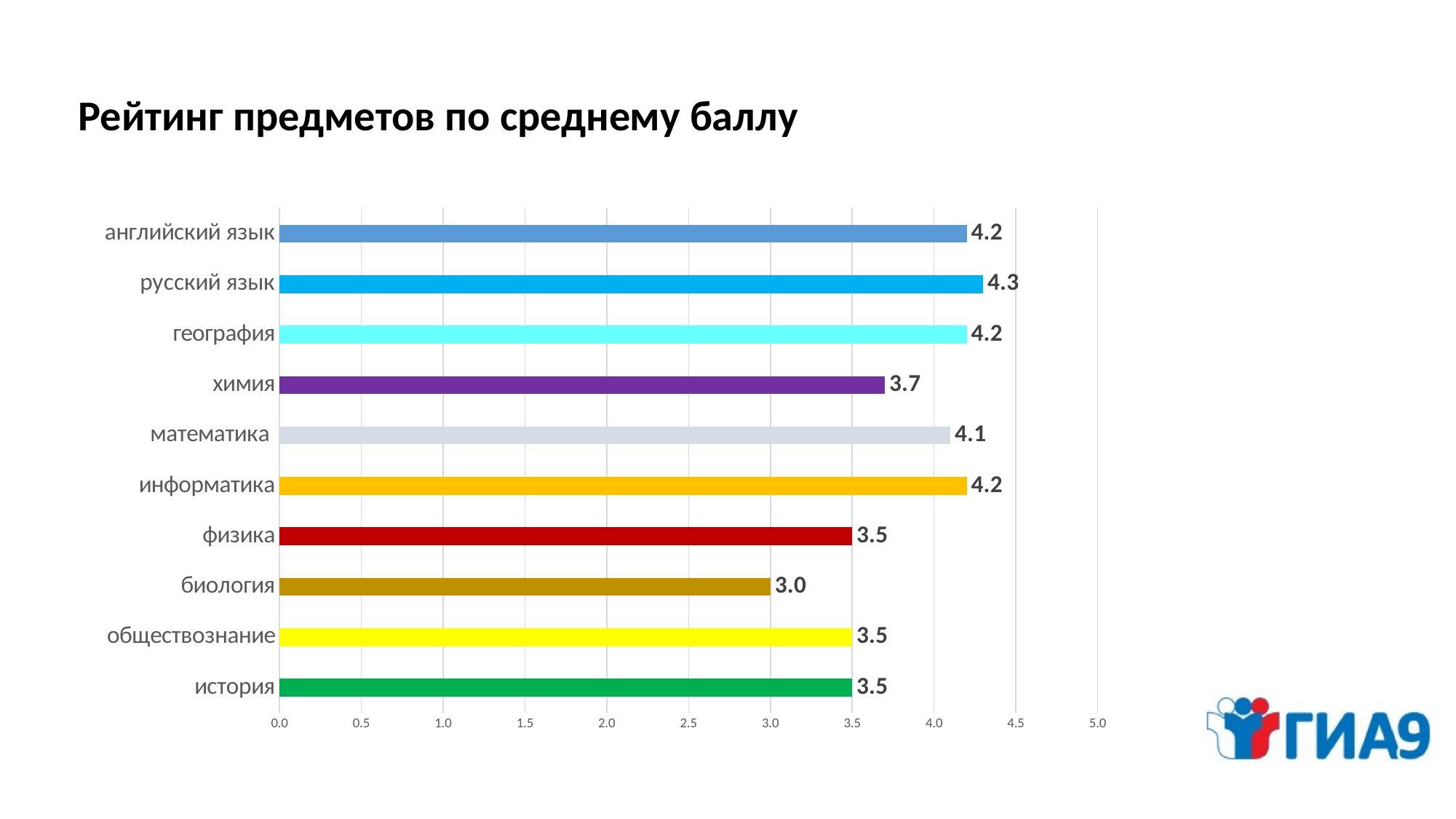
What is the difference between the average scores for математика and химия? 0.4 What is the average score for русский язык? 4.3 What is the average score for математика? 4.1 Which has a higher average score, химия or физика? химия What is the average score for химия? 3.7 What is the difference between the average scores for русский язык and биология? 1.3 What is the title of the chart? Рейтинг предметов по среднему баллу Which subject has the lowest average score? биология Which subject has the highest average score? русский язык What type of chart is shown on the slide? bar chart What is the average score for биология? 3.0 How many subjects are shown in the chart? 10